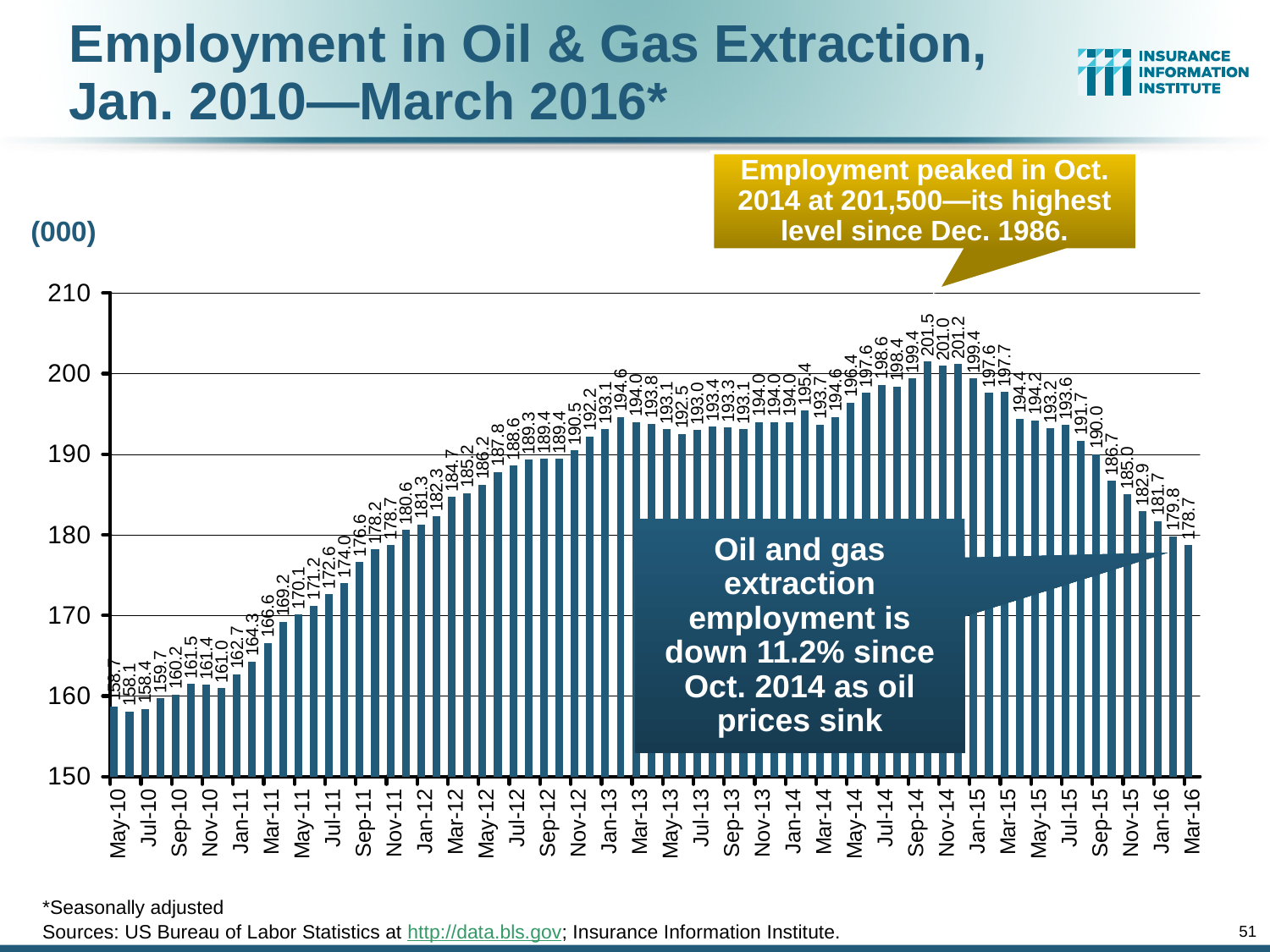
What was the peak employment value shown on the chart? 201.5 Which is larger, employment in Jan-15 or Jan-16? Jan-15 What was employment in oil & gas extraction in Mar-16? 178.7 What was employment in oil & gas extraction in Jan-16? 181.7 What was employment in oil & gas extraction in May-10? 158.7 What unit is indicated for the y-axis values? (000) Is the value for Sep-15 greater or less than 180? greater What kind of chart is shown on the slide? Bar chart In which month did employment in oil & gas extraction peak? Oct. 2014 How does employment trend from May-10 to Oct-14? It rises What is the difference between the peak value (201.5) and the Mar-16 value (178.7)? 22.8 What was employment in oil & gas extraction in Jan-15? 199.4